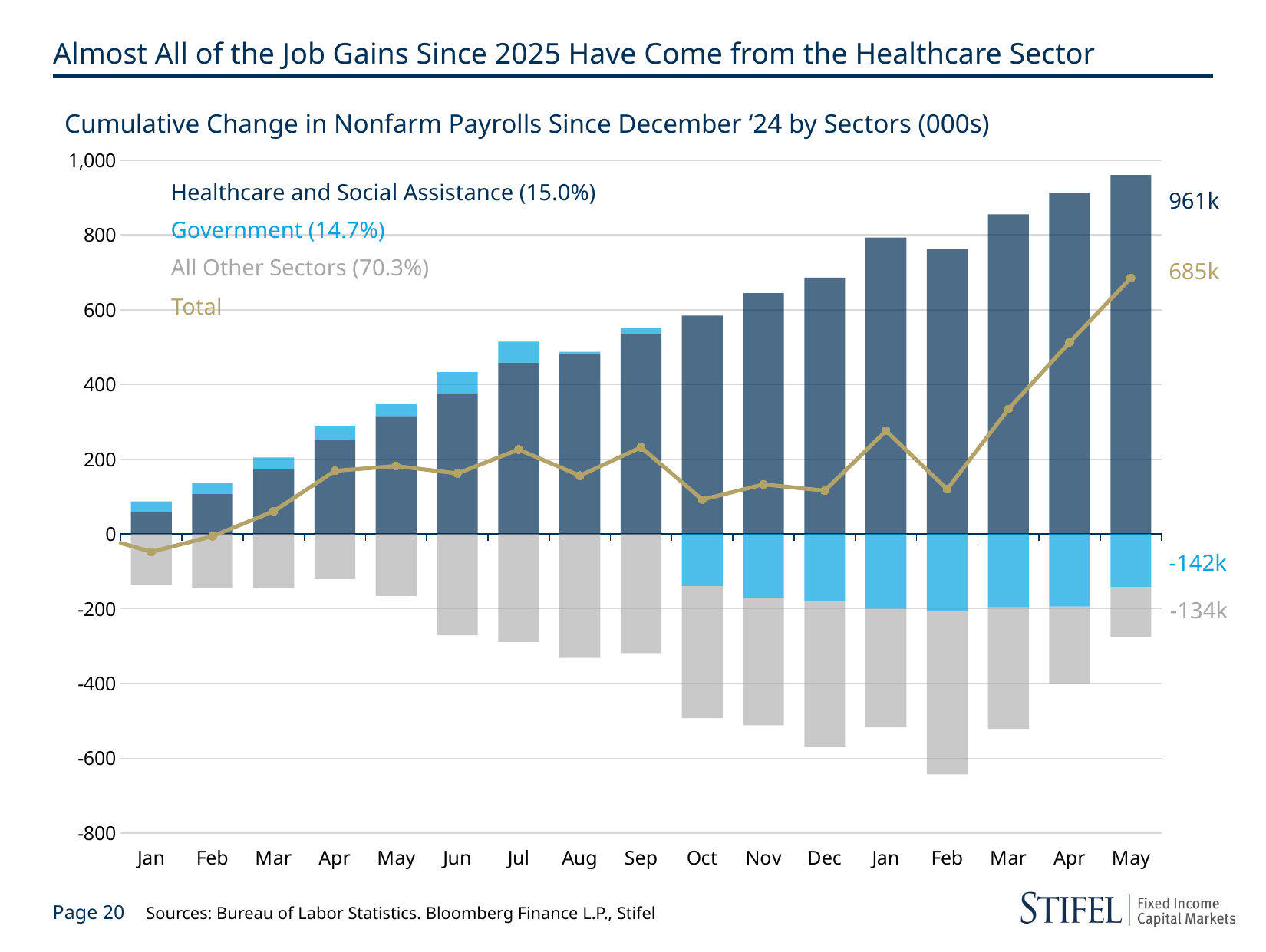
What is the cumulative change for All Other Sectors in the final month (May)? -134k What is the difference between the Healthcare and Social Assistance value (961k) and the Total value (685k) in the final month? 276k What is the cumulative change for Government in the final month (May)? -142k How many series does the chart legend list? 4 Is the Healthcare and Social Assistance value in the first month (Jan) greater or less than 200? less What kind of chart is this? Stacked bar chart with a line What is the cumulative change for Healthcare and Social Assistance in the final month (May)? 961k Do the Healthcare and Social Assistance bars generally rise or fall from left to right along the x axis? Rise What is the title of the chart? Cumulative Change in Nonfarm Payrolls Since December ‘24 by Sectors (000s) In the final month (May), which is larger: the Healthcare and Social Assistance value or the Total value? Healthcare and Social Assistance What is the Total cumulative change in the final month (May)? 685k How many months are shown along the x axis? 17